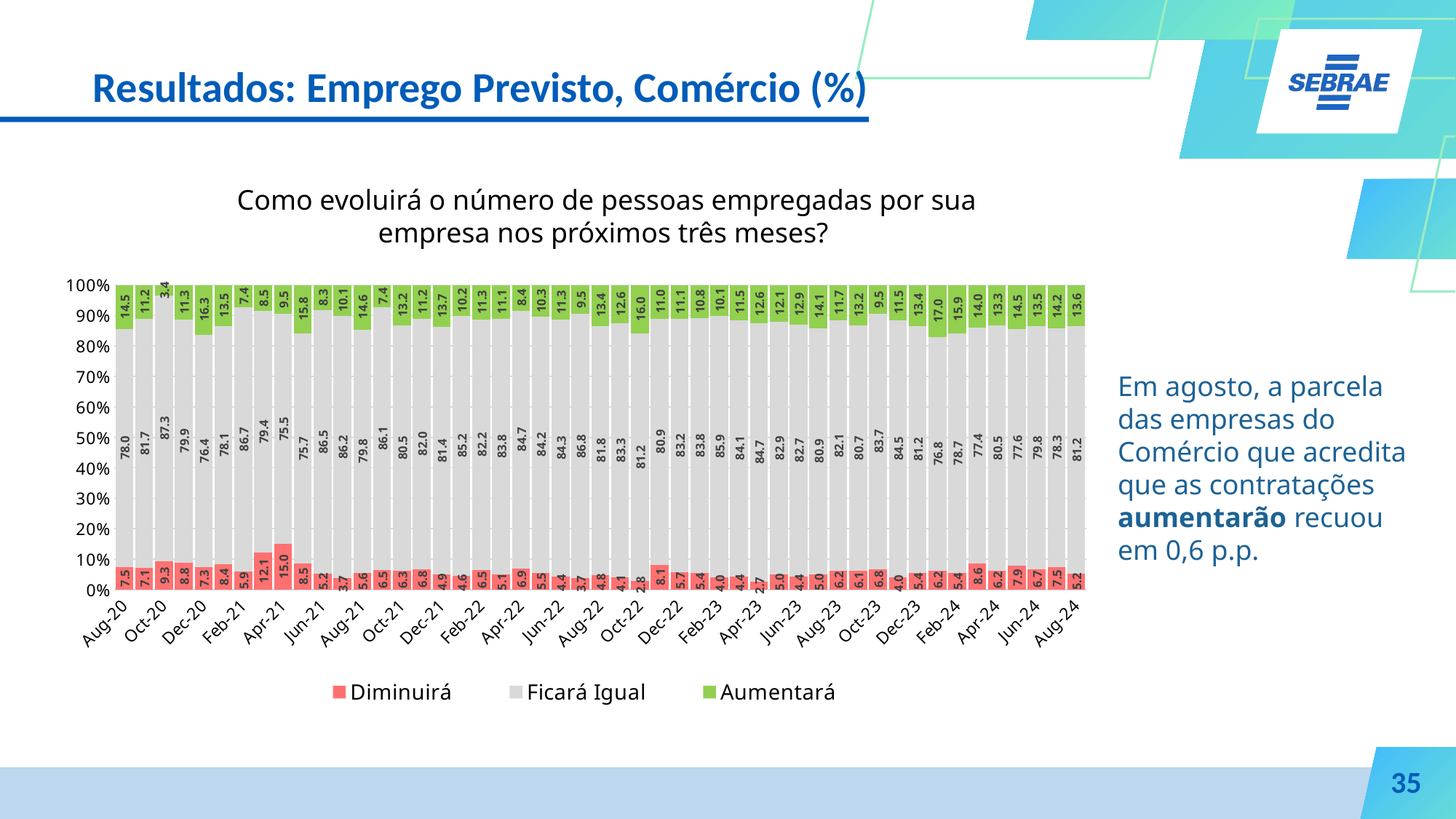
What kind of chart is shown on the slide? Stacked bar chart What is the value of Diminuirá for Apr-21? 15.0 Which labeled month has the lowest Aumentará value? Oct-20 What is the difference between the Aumentará value for Aug-20 and for Aug-24? 0.9 How many series does the legend list? 3 What is the value of Aumentará for Aug-24? 13.6 Which labeled month has the highest Diminuirá value? Apr-21 What is the value of Ficará Igual for Feb-24? 78.7 What are the three legend entries of the chart? Diminuirá, Ficará Igual, Aumentará Which has the larger Diminuirá value, Aug-20 or Aug-24? Aug-20 What is the value of Ficará Igual for Oct-20? 87.3 What is the total of the three segments of the Aug-24 bar? 100.0